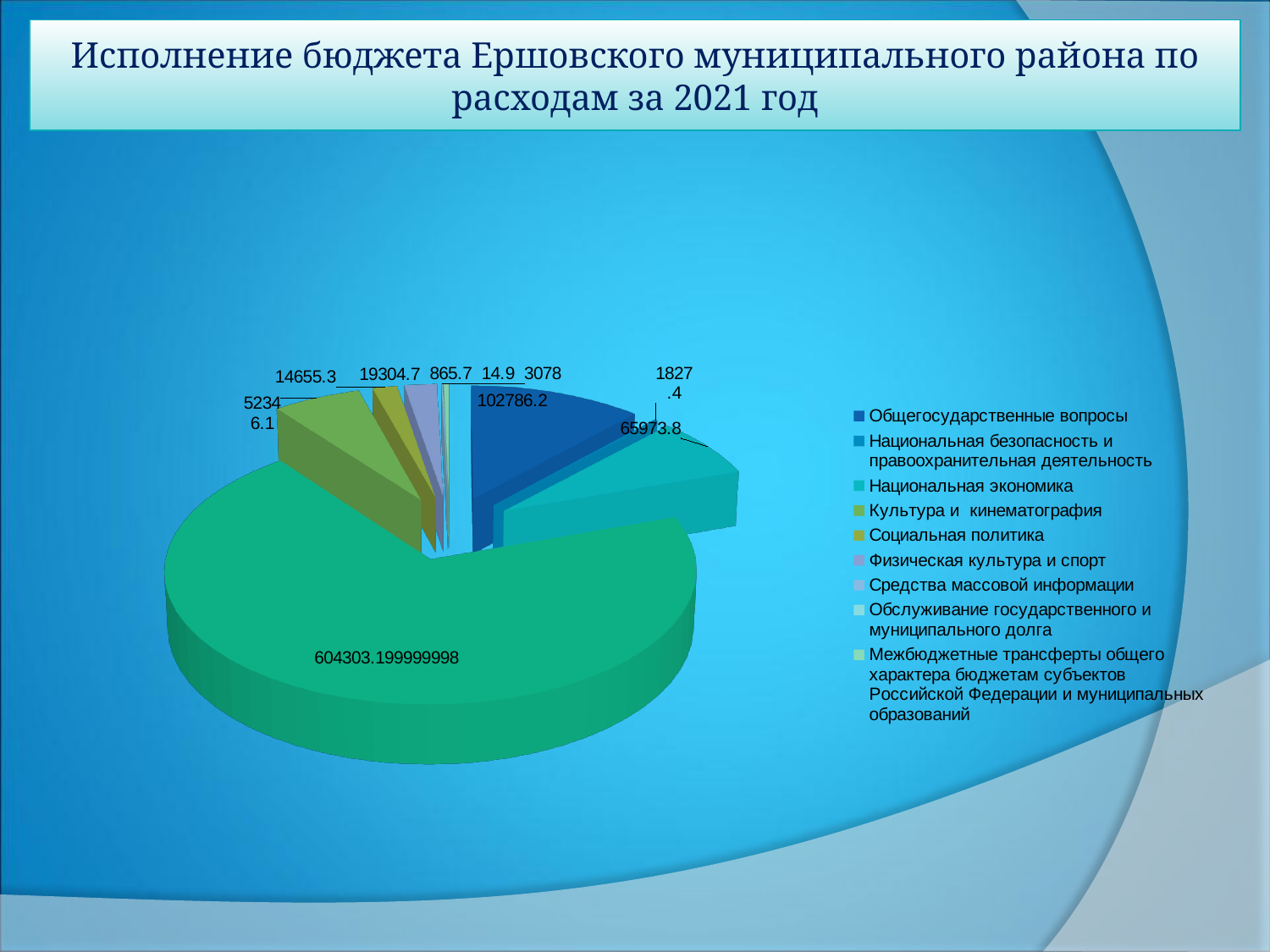
What is the value for Национальная безопасность и правоохранительная деятельность? 1827.4 What kind of chart is shown on the slide? pie chart What is the value for Национальная экономика? 65973.8 How many data labels are shown on the pie chart? 10 What is the largest value labelled on the pie chart? 604303.199999998 Which is larger, Общегосударственные вопросы or Национальная экономика? Общегосударственные вопросы What is the difference between the values for Общегосударственные вопросы and Национальная экономика? 36812.4 How many entries does the legend list? 9 What is the smallest value labelled on the pie chart? 14.9 Which legend entry is listed first? Общегосударственные вопросы What is the value for Общегосударственные вопросы? 102786.2 What is the title of the chart on the slide? Исполнение бюджета Ершовского муниципального района по расходам за 2021 год